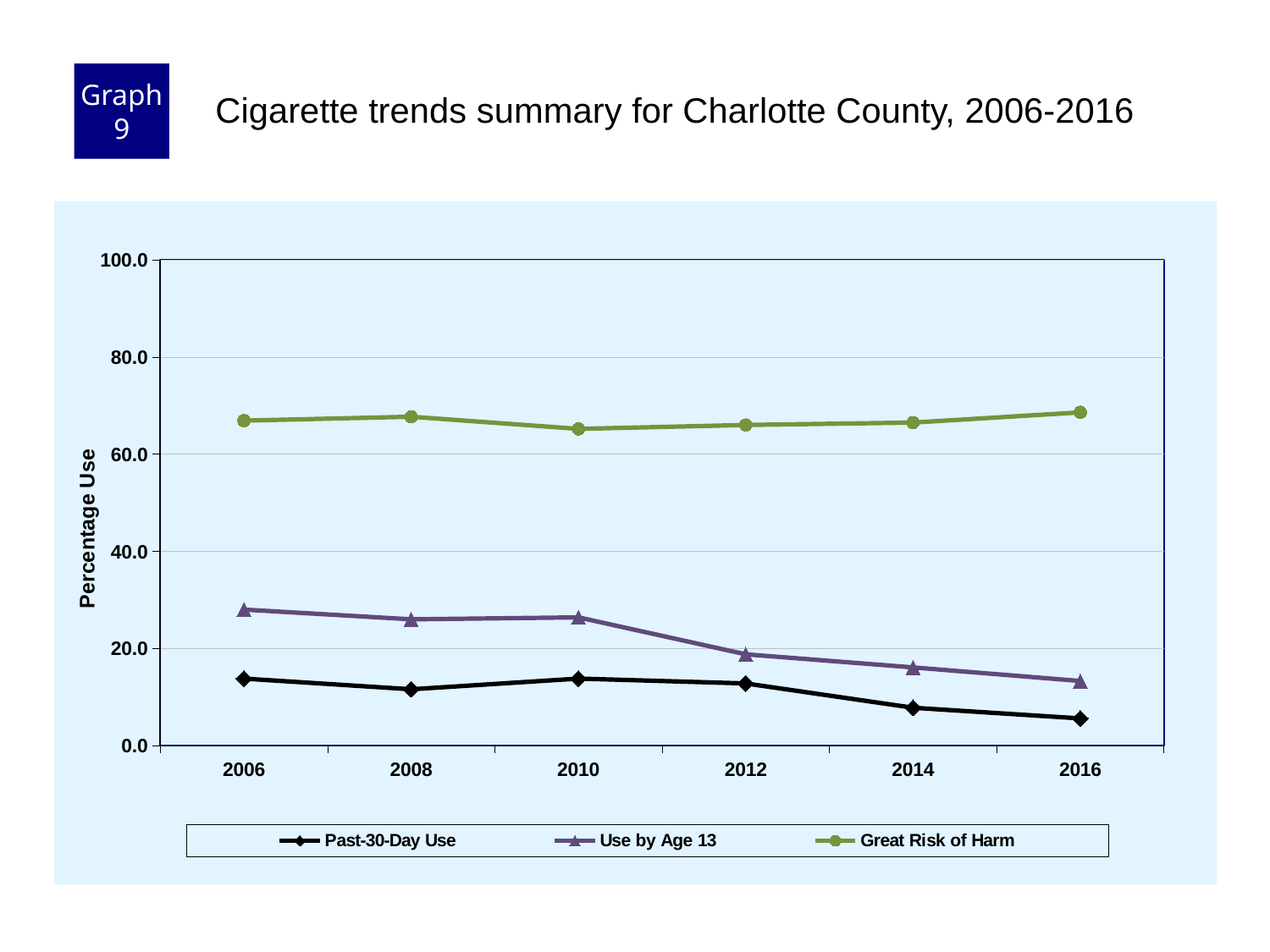
Does Use by Age 13 rise or fall from 2006 to 2016? Fall In 2012, which is larger: Great Risk of Harm or Past-30-Day Use? Great Risk of Harm Is the value for Use by Age 13 in 2006 greater or less than 20.0? greater What is the label on the y axis? Percentage Use What kind of chart is shown on the slide? Line chart Is the value for Great Risk of Harm in 2006 greater or less than 60.0? greater In which year is Past-30-Day Use at its lowest? 2016 How many series does the legend list? 3 How many years are plotted along the x axis? 6 Is the value for Past-30-Day Use in 2016 greater or less than 20.0? less Which series has the highest values across all years? Great Risk of Harm